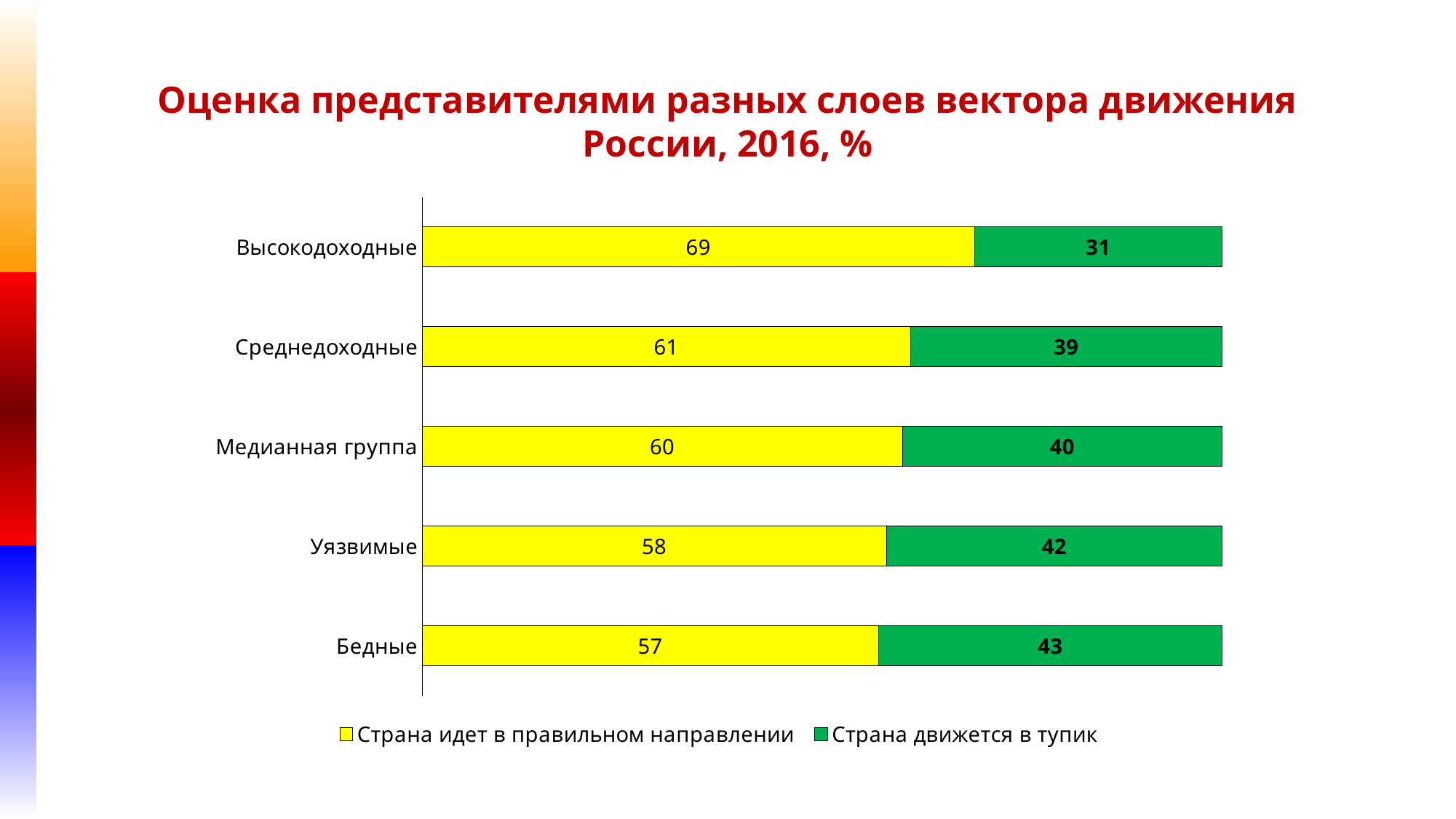
What is the difference between the «Страна идет в правильном направлении» values for «Высокодоходные» and «Бедные»? 12 What is the value for «Страна идет в правильном направлении» for the «Высокодоходные» group? 69 What is the value for «Страна движется в тупик» for the «Бедные» group? 43 Which is larger: the «Страна движется в тупик» value for «Уязвимые» or for «Среднедоходные»? Уязвимые How many series does the legend list? 2 What is the total of the stacked bar for «Среднедоходные»? 100 Which colour represents «Страна движется в тупик» in the chart? Green Which group has the lowest value for «Страна движется в тупик»? Высокодоходные What kind of chart is shown on the slide? Stacked bar chart How many groups (categories) are shown on the chart? 5 Which group has the highest value for «Страна идет в правильном направлении»? Высокодоходные What is the value for «Страна движется в тупик» for the «Медианная группа»? 40